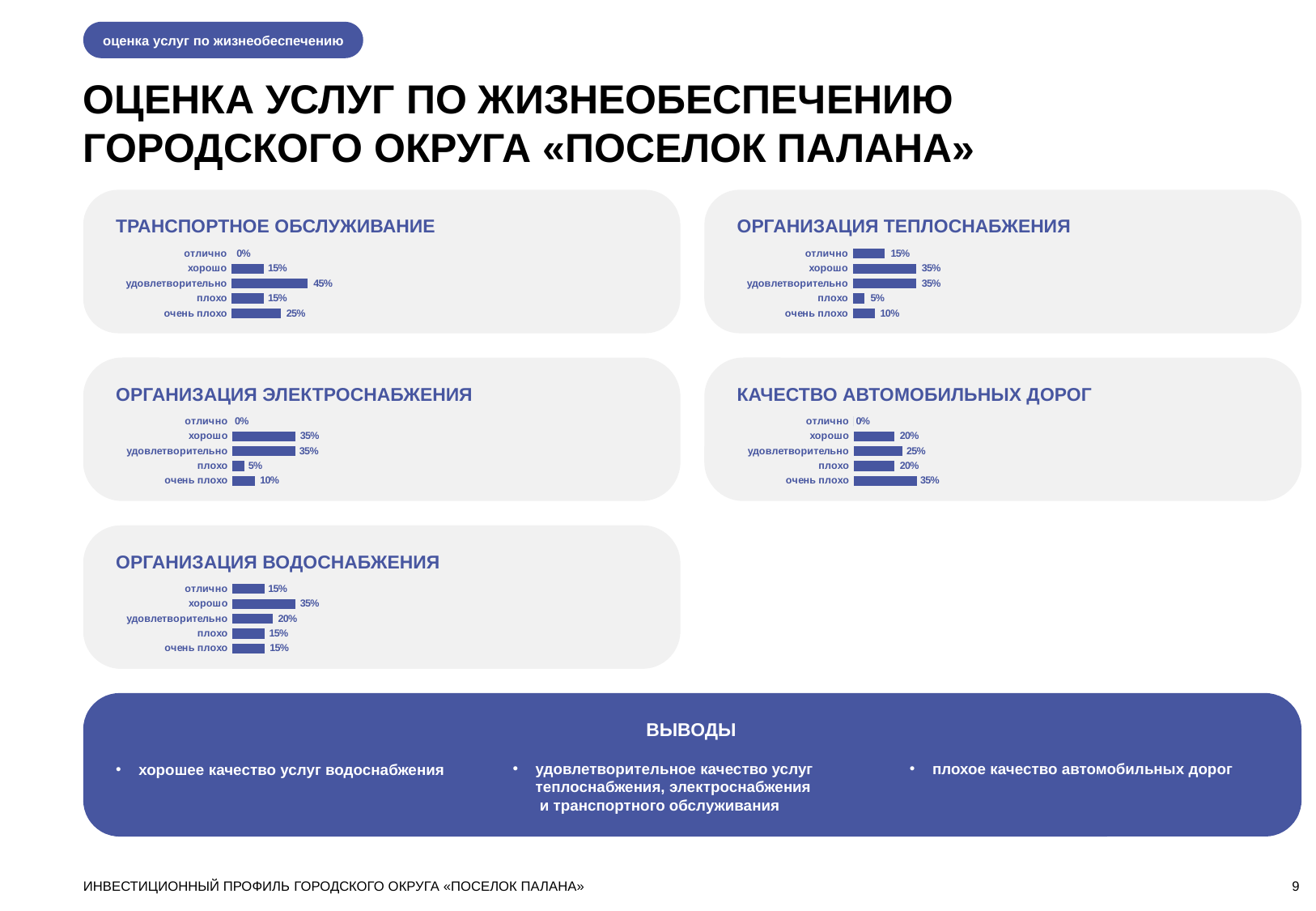
In the "ОРГАНИЗАЦИЯ ЭЛЕКТРОСНАБЖЕНИЯ" chart, what is the difference between "хорошо" and "очень плохо"? 25% In the "КАЧЕСТВО АВТОМОБИЛЬНЫХ ДОРОГ" chart, which category has the highest value? очень плохо In the "ОРГАНИЗАЦИЯ ТЕПЛОСНАБЖЕНИЯ" chart, what is the value for "отлично"? 15% In the "КАЧЕСТВО АВТОМОБИЛЬНЫХ ДОРОГ" chart, which is larger: "удовлетворительно" or "плохо"? удовлетворительно What type of chart is the "ОРГАНИЗАЦИЯ ВОДОСНАБЖЕНИЯ" chart? bar chart In the "ТРАНСПОРТНОЕ ОБСЛУЖИВАНИЕ" chart, what is the value for "удовлетворительно"? 45% How many categories does the "ТРАНСПОРТНОЕ ОБСЛУЖИВАНИЕ" chart show? 5 In the "ОРГАНИЗАЦИЯ ТЕПЛОСНАБЖЕНИЯ" chart, which category has the lowest value? плохо In the "ОРГАНИЗАЦИЯ ВОДОСНАБЖЕНИЯ" chart, what is the difference between "хорошо" and "удовлетворительно"? 15% In the "ОРГАНИЗАЦИЯ ВОДОСНАБЖЕНИЯ" chart, what is the value for "хорошо"? 35% In the "ТРАНСПОРТНОЕ ОБСЛУЖИВАНИЕ" chart, which category has the highest value? удовлетворительно In the "ОРГАНИЗАЦИЯ ЭЛЕКТРОСНАБЖЕНИЯ" chart, what is the value for "отлично"? 0%